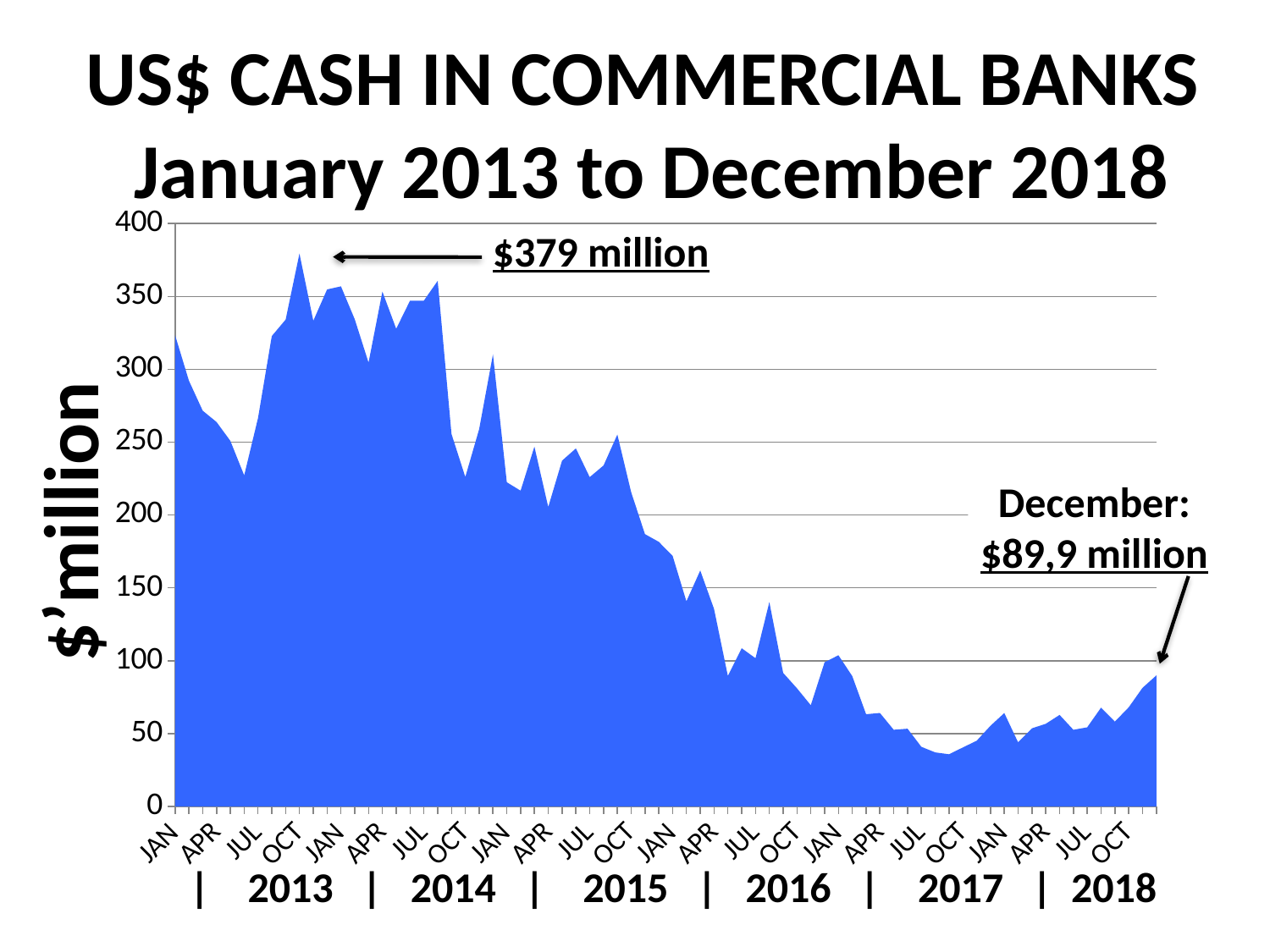
Is the value for January 2013 greater or less than 300? greater Is the value for January 2015 greater or less than 200? greater Is the value for October 2017 greater or less than 50? less How many years are labelled along the x axis? 6 Overall, do the values rise or fall from January 2013 to December 2018? fall What is the peak value of US$ cash in commercial banks marked on the chart? $379 million What is the highest tick value shown on the vertical axis? 400 What is the value of US$ cash in commercial banks for December 2018? $89,9 million Which is larger, the value in January 2013 or the value in December 2018? January 2013 What kind of chart is shown on the slide? area chart What is the label on the vertical axis? $'million